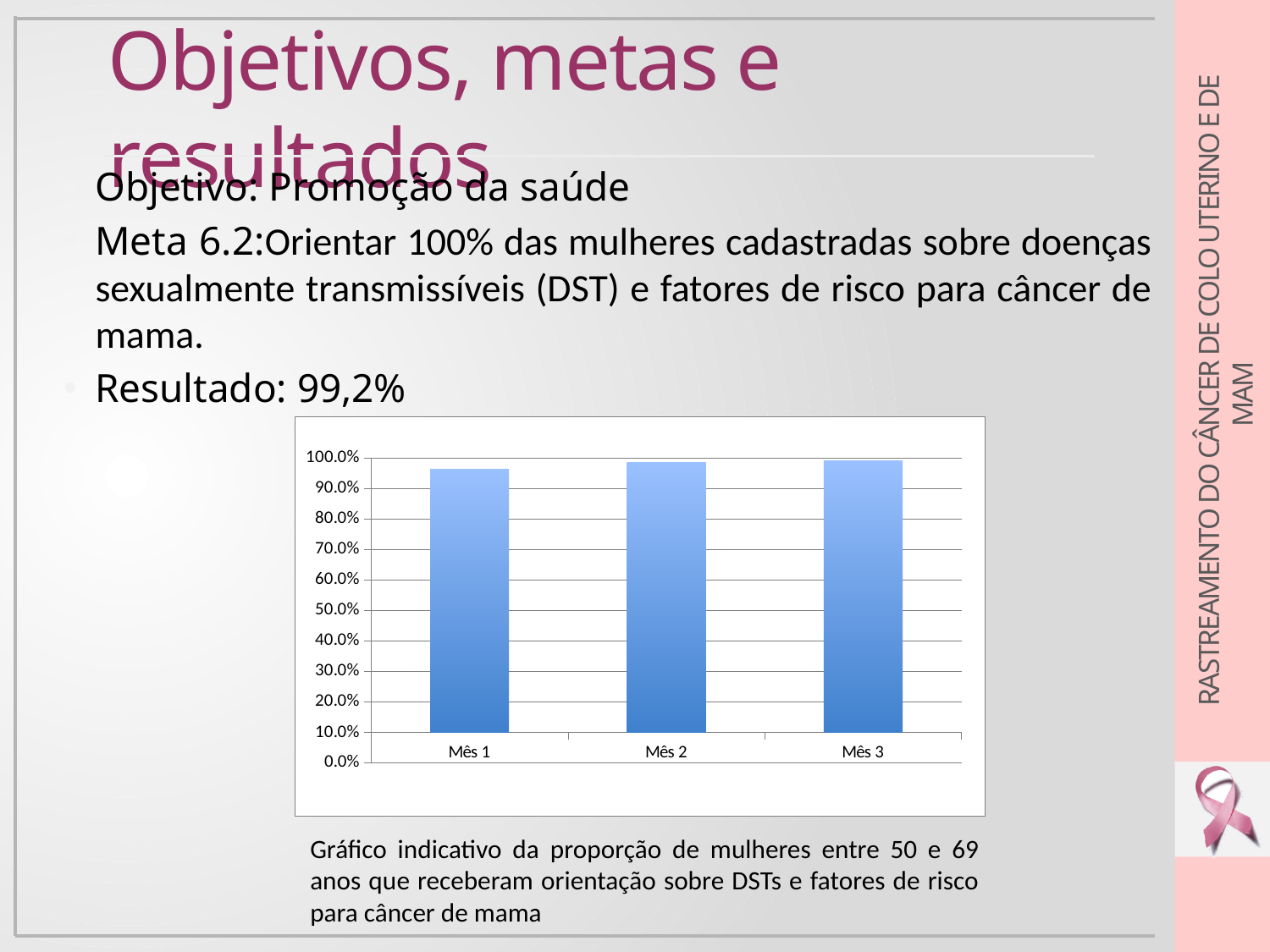
Which category has the lowest value in the chart? Mês 1 Which is larger, the value for Mês 1 or the value for Mês 2? Mês 2 How many categories (bars) does the chart show? 3 Which is larger, the value for Mês 1 or the value for Mês 3? Mês 3 Is the value for Mês 2 greater or less than 80.0%? greater Do the values rise or fall from Mês 1 to Mês 3? rise Is the value for Mês 1 greater or less than 90.0%? greater What are the category labels on the x axis of the chart? Mês 1, Mês 2, Mês 3 What kind of chart is shown on the slide? bar chart What is the highest tick value shown on the chart's y axis? 100.0%